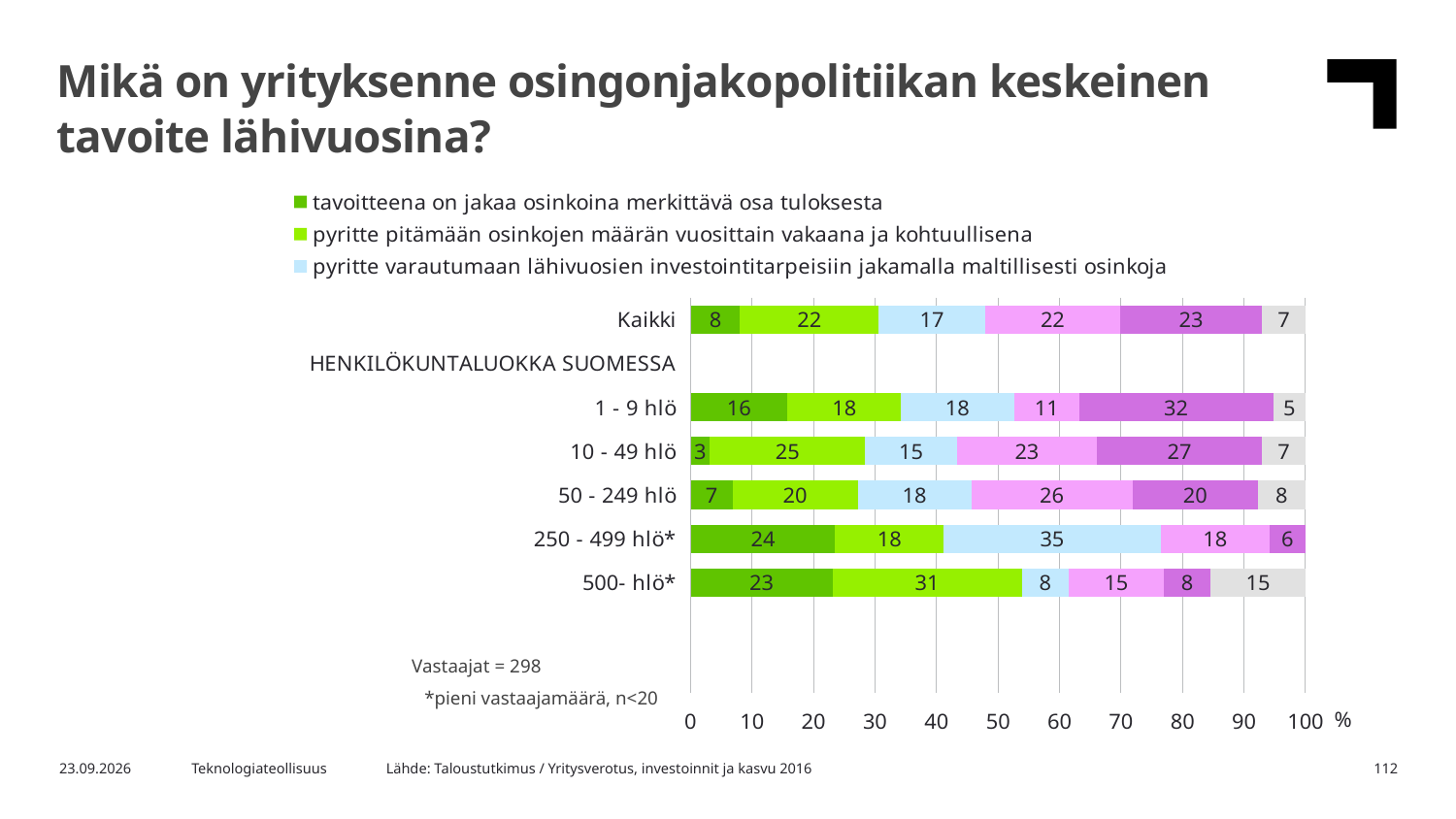
What is the value for '500- hlö*' in the series 'pyritte pitämään osinkojen määrän vuosittain vakaana ja kohtuullisena'? 31 What is the value for 'Kaikki' in the series 'tavoitteena on jakaa osinkoina merkittävä osa tuloksesta'? 8 How many entries does the legend list? 3 What is the value for '250 - 499 hlö*' in the series 'pyritte varautumaan lähivuosien investointitarpeisiin jakamalla maltillisesti osinkoja'? 35 Which category has the lowest value in the series 'pyritte varautumaan lähivuosien investointitarpeisiin jakamalla maltillisesti osinkoja'? 500- hlö* What is the difference between the '500- hlö*' and 'Kaikki' values in the series 'pyritte pitämään osinkojen määrän vuosittain vakaana ja kohtuullisena'? 9 Which category has the highest value in the series 'tavoitteena on jakaa osinkoina merkittävä osa tuloksesta'? 250 - 499 hlö* What kind of chart is shown on the slide? Stacked bar chart In the series 'tavoitteena on jakaa osinkoina merkittävä osa tuloksesta', which is larger: '1 - 9 hlö' or '50 - 249 hlö'? 1 - 9 hlö What is the total of all segments in the '1 - 9 hlö' bar? 100 How many categories have bars plotted in the chart? 6 Which category has the lowest value in the series 'tavoitteena on jakaa osinkoina merkittävä osa tuloksesta'? 10 - 49 hlö